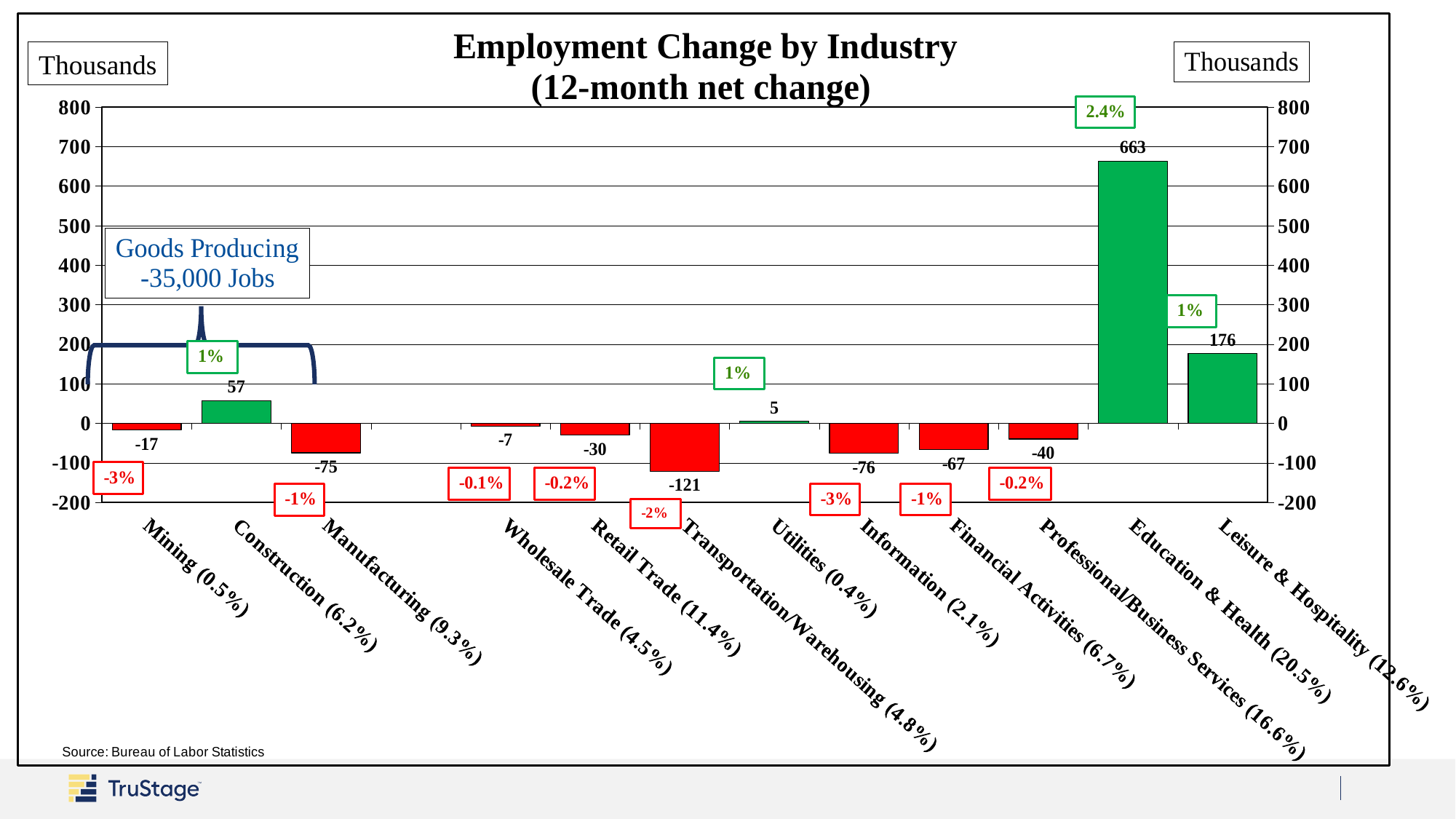
What is the value for Education & Health? 663 What is the value for Professional/Business Services? -40 How many industries are shown on the chart? 12 What is the value for Transportation/Warehousing? -121 What is the value for Construction? 57 What is the title of the chart? Employment Change by Industry (12-month net change) What unit is shown on the vertical axis label? Thousands Which industry has the highest employment change? Education & Health What is the difference between the values for Education & Health and Leisure & Hospitality? 487 Which is larger, the value for Construction or the value for Utilities? Construction What kind of chart is this? Bar chart Which industry has the lowest employment change? Transportation/Warehousing